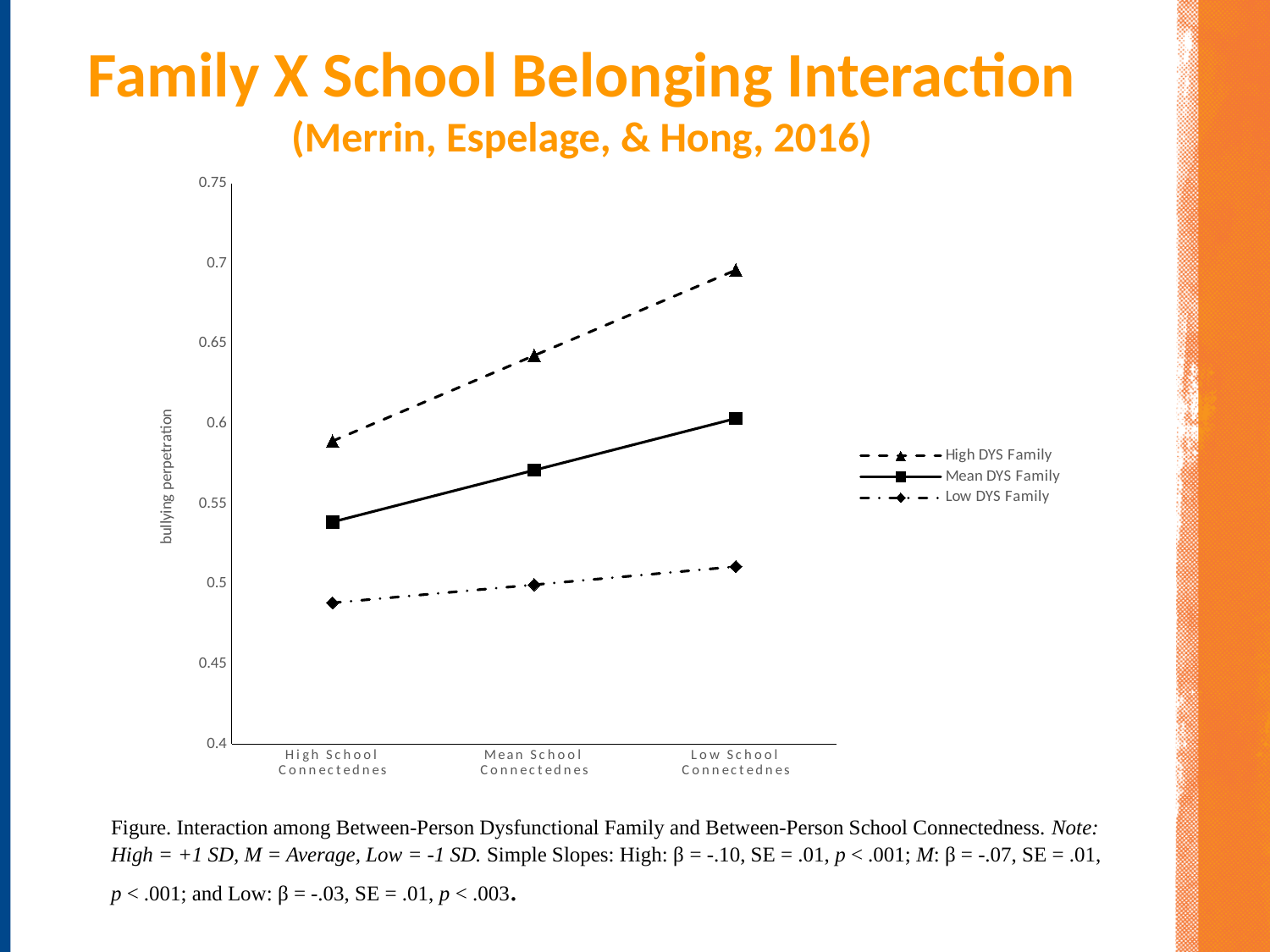
At Mean School Connectedness, which is larger: the value for High DYS Family or the value for Low DYS Family? High DYS Family How many categories are shown along the x axis? 3 Is the value for Mean DYS Family at High School Connectedness greater or less than 0.55? less Is the value for High DYS Family at High School Connectedness greater or less than 0.55? greater What kind of chart is shown on the slide? line chart How many series does the legend list? 3 Do the values for High DYS Family rise or fall from High School Connectedness to Low School Connectedness? rise What is the label on the y axis of the chart? bullying perpetration Which series has the highest value at Low School Connectedness? High DYS Family Which series has the lowest value at High School Connectedness? Low DYS Family Is the value for Low DYS Family at High School Connectedness greater or less than 0.5? less